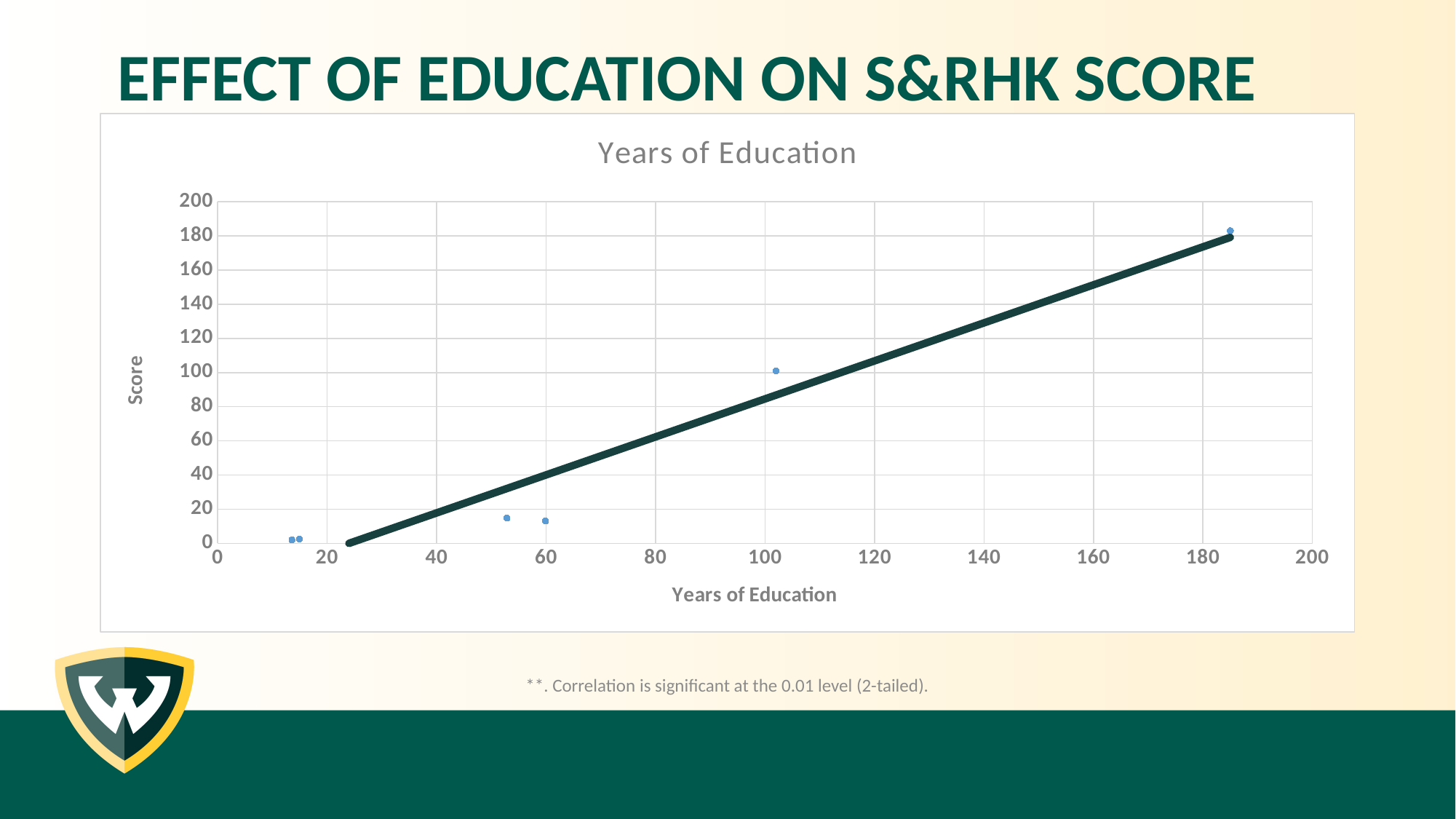
Is the score for the point at about 53 years of education greater or less than 40? less Is the score for the point at about 60 years of education greater or less than 40? less Which point has the highest score: the one at about 100 years of education or the one at about 185 years of education? the one at about 185 years of education Is the score for the point at about 100 years of education greater or less than 80? greater What kind of chart is shown on the slide? scatter chart How many data points are plotted on the chart? 6 What is the title of the chart? Years of Education What is the label on the vertical axis of the chart? Score Do the scores rise or fall as years of education increase along the x axis? rise What is the maximum value shown on the vertical axis? 200